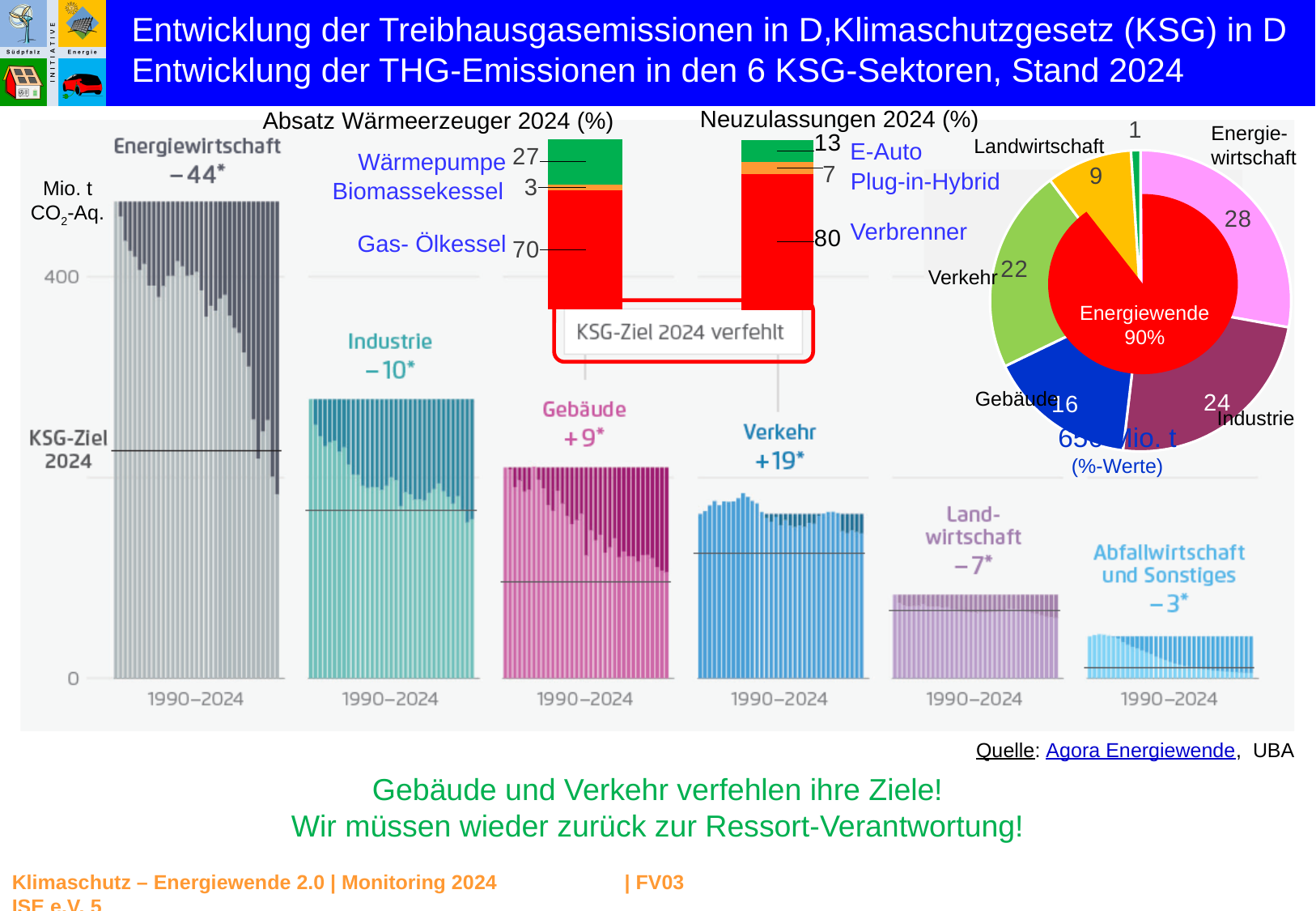
In the sector chart, do the Gebäude values rise or fall from 1990 to 2024? fall In the 'Absatz Wärmeerzeuger 2024 (%)' stacked bar, what is the value for Wärmepumpe? 27 In the 'Neuzulassungen 2024 (%)' stacked bar, what is the difference between Verbrenner and E-Auto? 67 In the pie chart on the right, what share is shown for Energiewirtschaft? 28 In the sector chart (1990–2024), what change is shown for the Verkehr sector? +19* What kind of chart is 'Absatz Wärmeerzeuger 2024 (%)'? stacked bar chart In the sector chart (1990–2024), which sector shows the largest decrease? Energiewirtschaft In the pie chart on the right, which is larger, Industrie or Verkehr? Industrie In the sector chart, is the 2024 value for Energiewirtschaft greater or less than 400? less In the 'Neuzulassungen 2024 (%)' stacked bar, what is the value for Verbrenner? 80 In the 'Absatz Wärmeerzeuger 2024 (%)' stacked bar, what is the difference between Gas- Ölkessel and Wärmepumpe? 43 How many sectors are shown in the sector chart (1990–2024)? 6